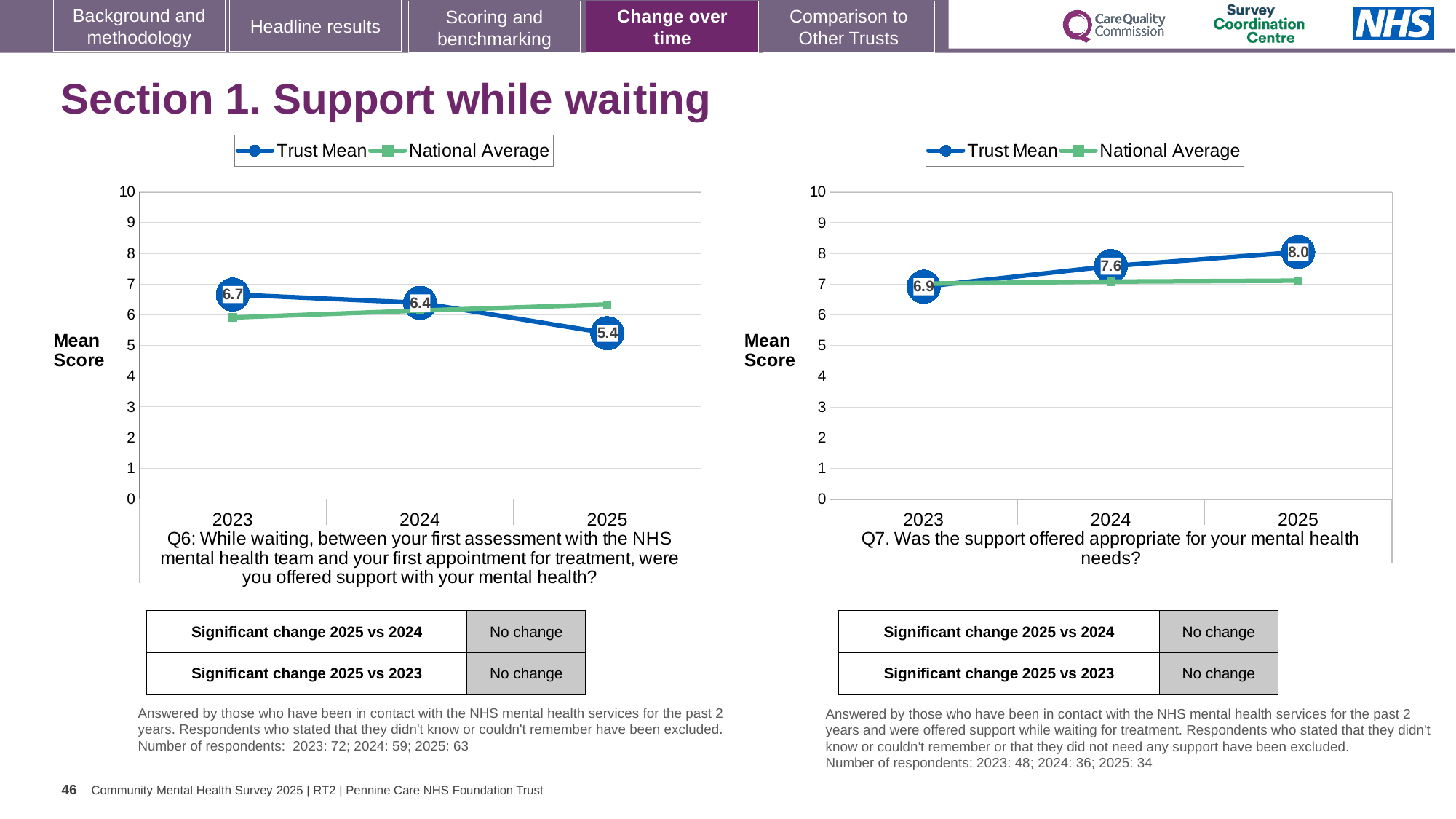
In the Q6 chart on the left, is the National Average for 2023 greater or less than 7? less In the Q6 chart on the left, does the Trust Mean rise or fall from 2023 to 2025? fall In the Q6 chart on the left, which year has the lowest Trust Mean? 2025 In the Q7 chart on the right, does the Trust Mean rise or fall from 2023 to 2025? rise In the Q7 chart on the right, which year has the highest Trust Mean? 2025 In the Q6 chart on the left, what is the Trust Mean for 2023? 6.7 In the Q6 chart on the left, what is the Trust Mean for 2025? 5.4 How many series does the legend of the Q7 chart on the right list? 2 In the Q7 chart on the right, what is the Trust Mean for 2025? 8.0 In the Q6 chart on the left, what is the difference between the Trust Mean in 2023 and in 2025? 1.3 In the Q7 chart on the right, what is the Trust Mean for 2024? 7.6 In the Q7 chart on the right, what is the difference between the Trust Mean in 2025 and in 2023? 1.1